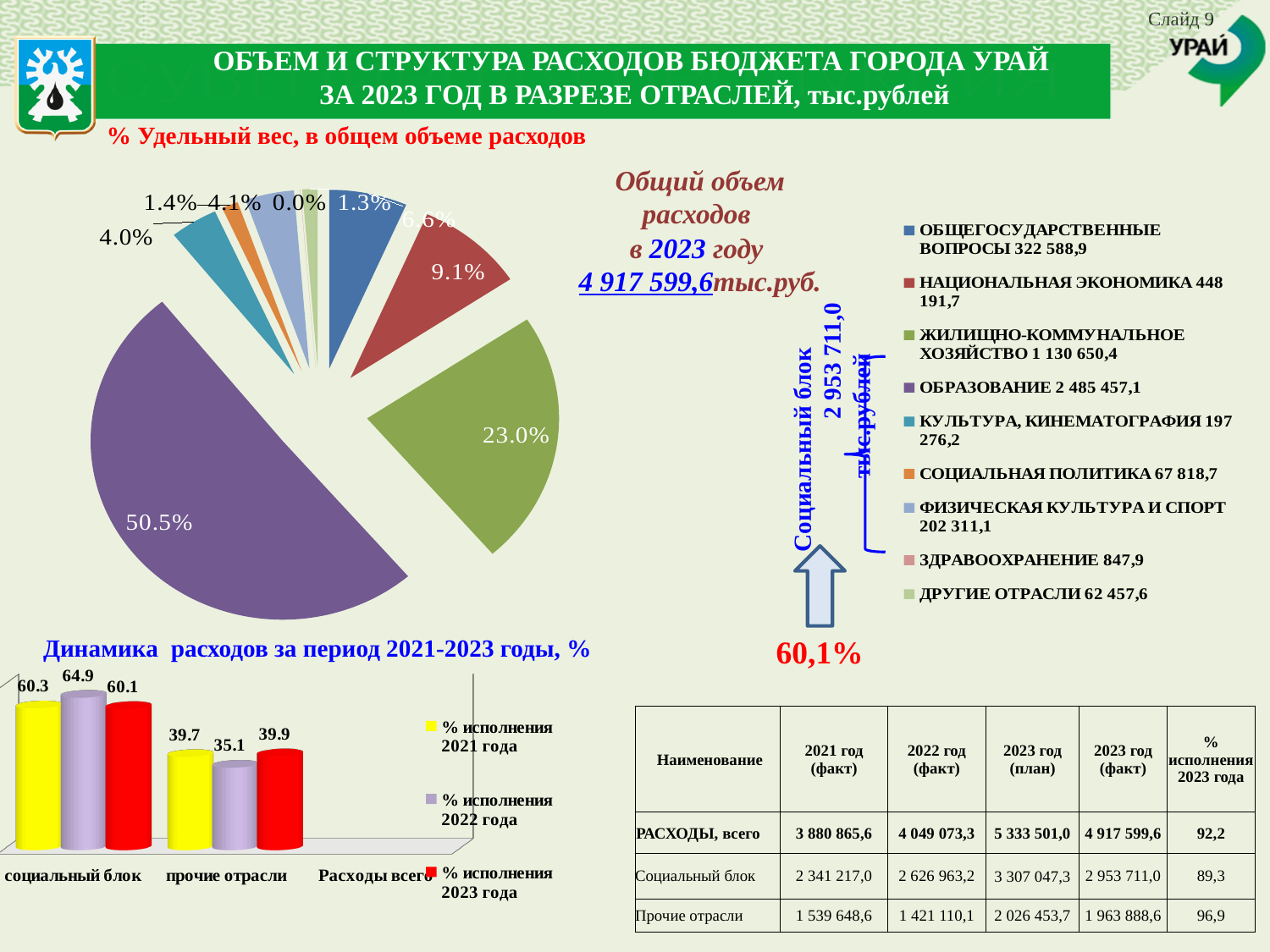
In the pie chart, what share of total expenditures does the largest slice represent? 50.5% How many entries does the legend of the pie chart list? 9 In the bar chart 'Динамика расходов за период 2021-2023 годы, %', how many series does the legend list? 3 According to the pie chart legend, what is the value for ОБРАЗОВАНИЕ? 2 485 457,1 In the bar chart 'Динамика расходов за период 2021-2023 годы, %', what is the value for прочие отрасли for % исполнения 2023 года? 39.9 In the pie chart, what percentage is shown for the red slice (НАЦИОНАЛЬНАЯ ЭКОНОМИКА)? 9.1% In the pie chart, what is the difference in percentage points between the 50.5% slice and the 23.0% slice? 27.5 In the bar chart 'Динамика расходов за период 2021-2023 годы, %', what is the value for социальный блок for % исполнения 2022 года? 64.9 According to the pie chart legend, what is the value for ЗДРАВООХРАНЕНИЕ? 847,9 What type of chart is 'Динамика расходов за период 2021-2023 годы, %'? bar chart In the pie chart, what percentage is shown for the green slice (ЖИЛИЩНО-КОММУНАЛЬНОЕ ХОЗЯЙСТВО)? 23.0% In the bar chart 'Динамика расходов за период 2021-2023 годы, %', which year has the lowest value for прочие отрасли? % исполнения 2022 года